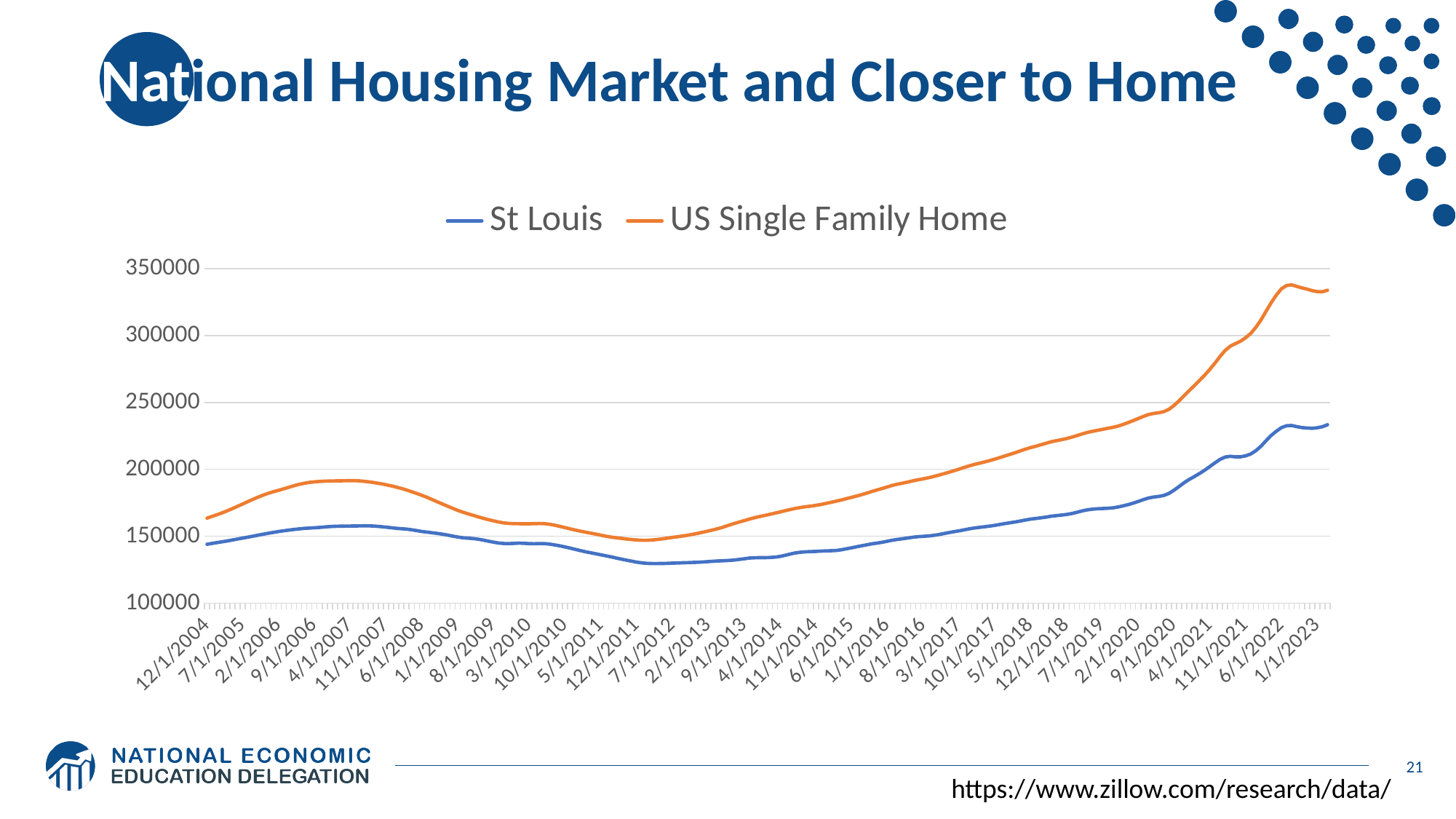
How many series does the legend list? 2 Which series is higher at 1/1/2023, St Louis or US Single Family Home? US Single Family Home Which series reaches the highest value on the chart? US Single Family Home What are the two series named in the legend? St Louis and US Single Family Home Does the St Louis line rise or fall between 4/1/2007 and 5/1/2011? fall Is the value for US Single Family Home at 4/1/2021 greater or less than 250000? greater Is the value for St Louis at 12/1/2004 greater or less than 150000? less Is the value for US Single Family Home at 12/1/2004 greater or less than 150000? greater What kind of chart is shown on the slide? line chart Which colour is used for the St Louis line? blue